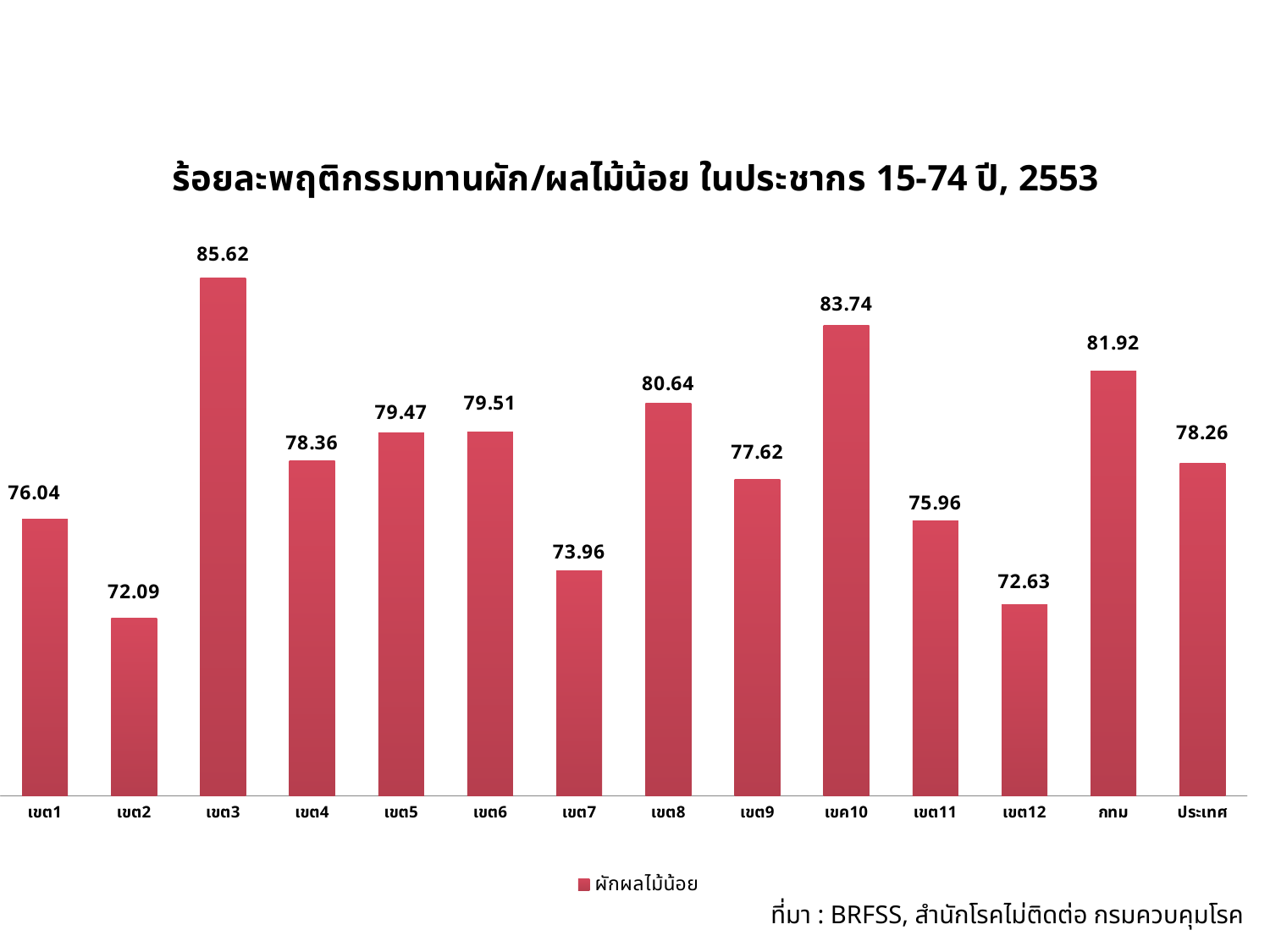
Which is larger, the value for เขต8 or the value for เขต9? เขต8 How many categories are shown on the x axis? 14 Which category has the lowest value? เขต2 What kind of chart is shown on the slide? bar chart Which category has the highest value? เขต3 What is the value for เขต3? 85.62 What is the difference between the values for กทม and ประเทศ? 3.66 Which is larger, the value for เขต10 or the value for เขต11? เขต10 How many series does the legend list? 1 What is the value for กทม? 81.92 What is the difference between the values for เขต3 and เขต2? 13.53 What is the value for ประเทศ? 78.26